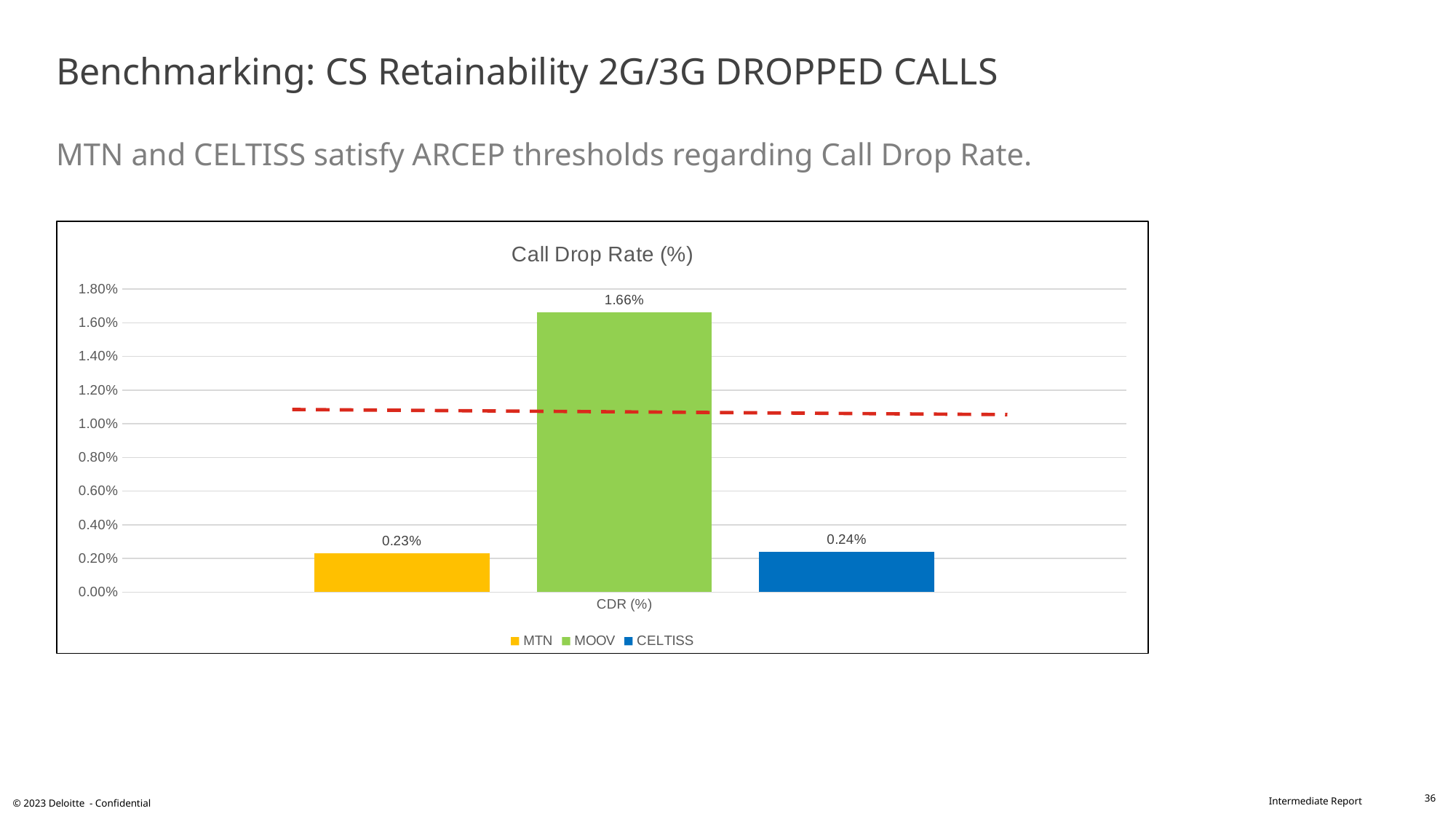
What is the title of the chart? Call Drop Rate (%) What is the Call Drop Rate for MTN? 0.23% Which colour represents MOOV in the chart? Green What is the difference between the Call Drop Rate of CELTISS and MTN? 0.01% How many series does the legend list? 3 What is the difference between the Call Drop Rate of MOOV and MTN? 1.43% What kind of chart is shown on the slide? Bar chart What is the Call Drop Rate for MOOV? 1.66% Which operator has the highest Call Drop Rate? MOOV What is the Call Drop Rate for CELTISS? 0.24% Is the Call Drop Rate for CELTISS greater or less than 0.40%? less Is the Call Drop Rate for MOOV greater or less than 1.00%? greater